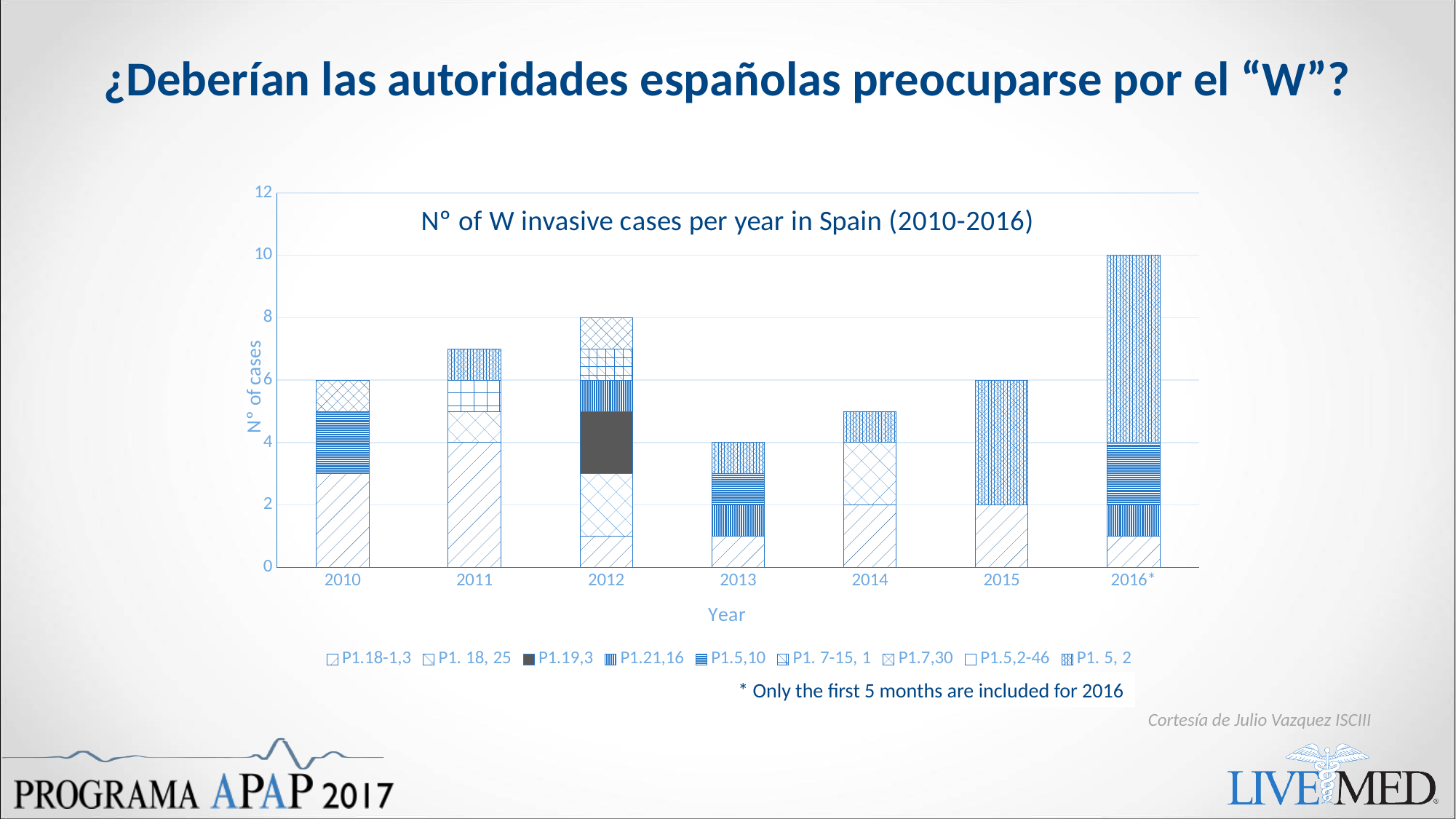
Which year has the highest total number of W invasive cases? 2016* What is the total number of cases in the stacked bar for 2012? 8 What is the title of the chart? N° of W invasive cases per year in Spain (2010-2016) From 2013 to 2016*, do the total cases per year rise or fall? rise What is the difference between the total cases in 2016* and in 2013? 6 Which year has the lowest total number of W invasive cases? 2013 What is the total number of cases in the stacked bar for 2016*? 10 Which year has a larger total of cases, 2012 or 2015? 2012 How many series does the chart legend list? 9 What kind of chart is shown on the slide? Stacked bar chart How many years are shown on the x axis of the chart? 7 Is the total number of cases for 2011 greater or less than 6? greater